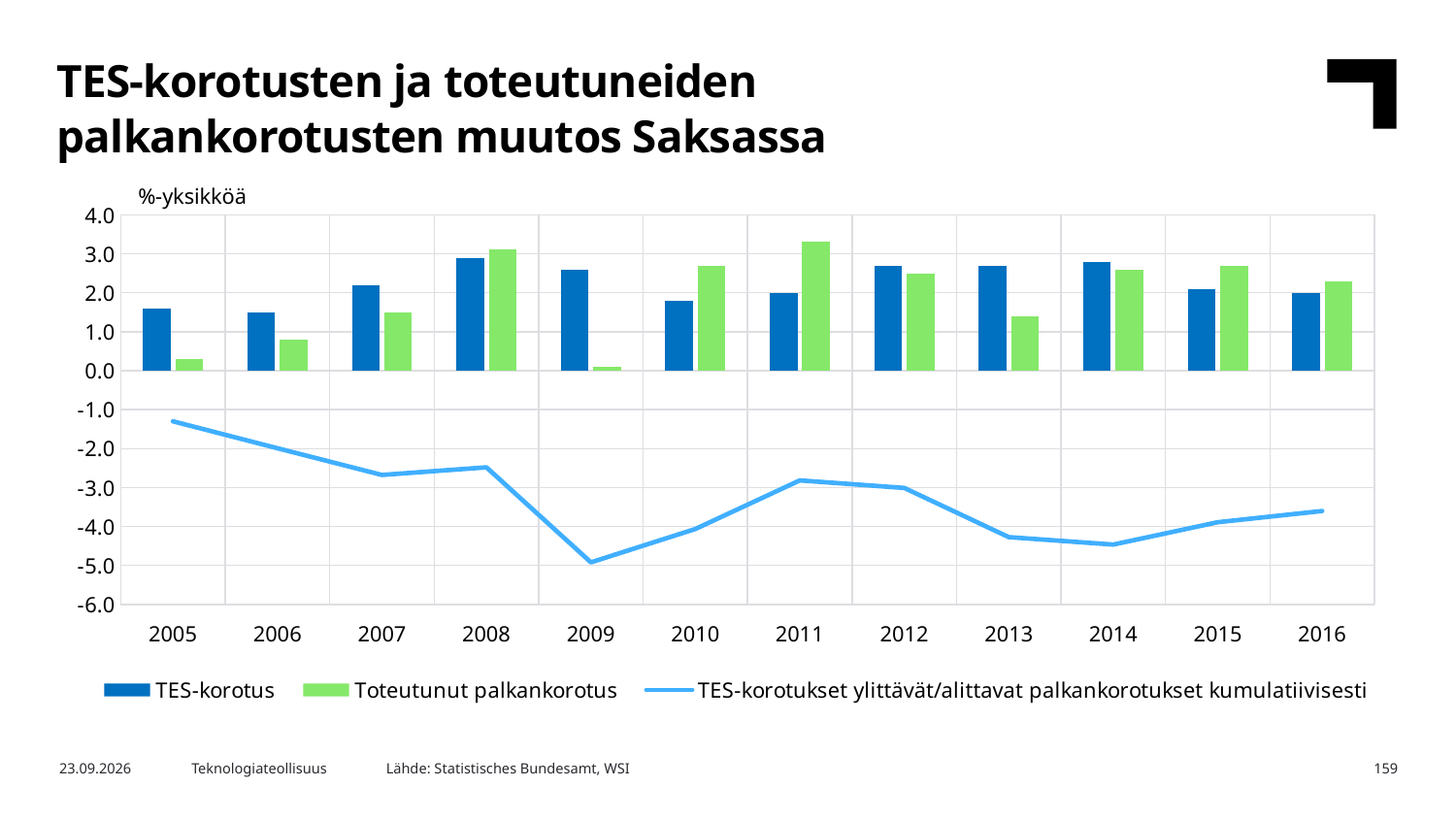
Is the Toteutunut palkankorotus value for 2005 greater or less than 1.0? less How many years are shown on the x axis? 12 In which year is the Toteutunut palkankorotus bar lowest? 2009 In 2005, which is larger: TES-korotus or Toteutunut palkankorotus? TES-korotus Does the cumulative line rise or fall from 2005 to 2009? fall In which year does the line TES-korotukset ylittävät/alittavat palkankorotukset kumulatiivisesti reach its lowest point? 2009 In 2011, which is larger: TES-korotus or Toteutunut palkankorotus? Toteutunut palkankorotus What kind of chart is this? Combined bar and line chart How many series does the legend list? 3 What unit is shown above the y axis? %-yksikköä Is the value of the cumulative line in 2009 greater or less than -4.0? less